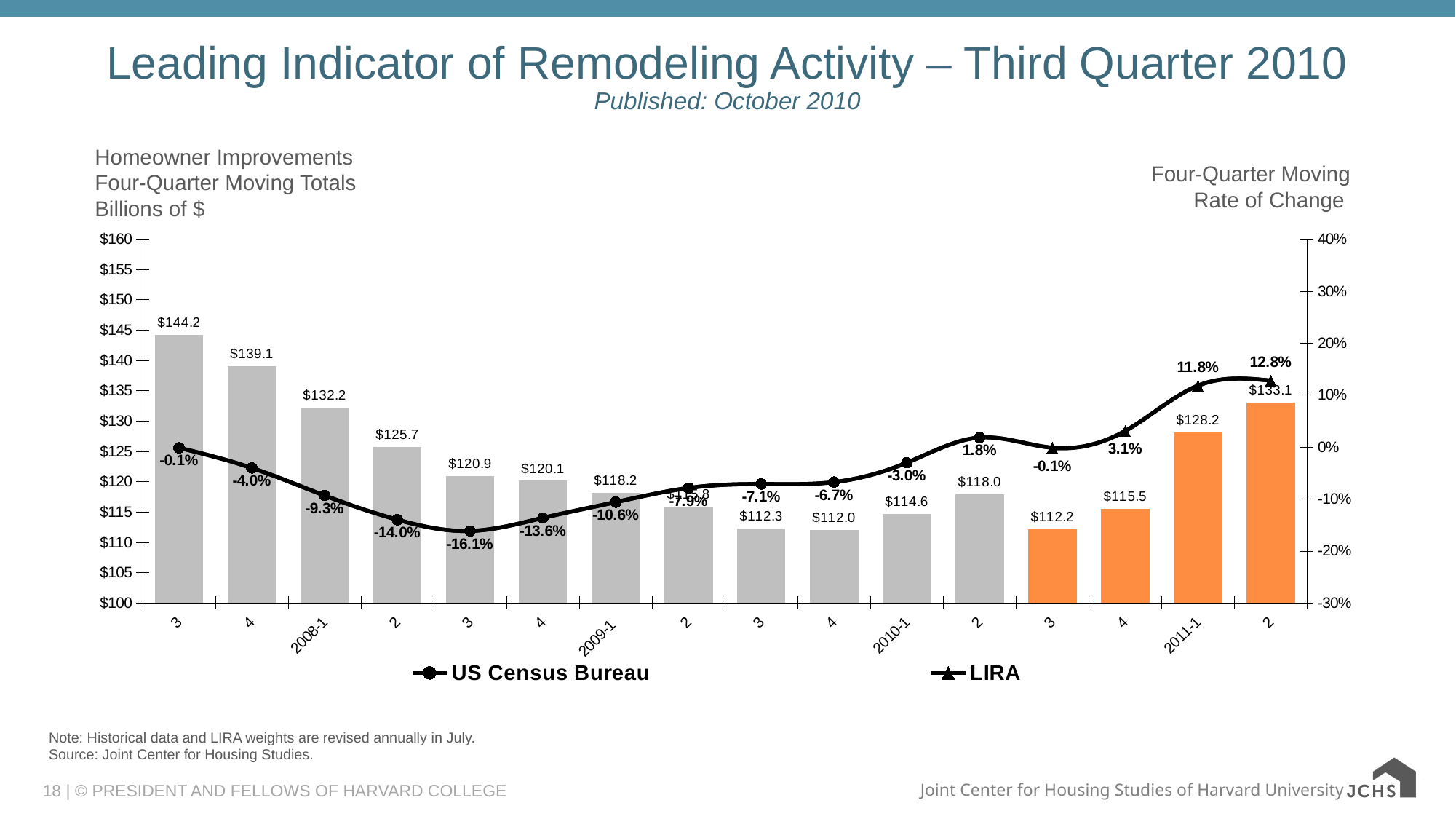
What is the highest Four-Quarter Moving Rate of Change value shown on the chart? 12.8% What is the value of the Homeowner Improvements bar for 2011-1? $128.2 Which quarter has the lowest Four-Quarter Moving Rate of Change? 2008 quarter 3 (the '3' after 2008-1), -16.1% Do the Homeowner Improvements bars rise or fall from 2008-1 to 2009-1? Fall What kind of chart is shown on the slide? A combination bar and line chart Which is larger, the Homeowner Improvements bar for 2010-1 or for 2009-1? 2009-1 What is the value of the Homeowner Improvements bar for 2008-1? $132.2 How many bars are plotted on the chart? 16 Which quarter has the highest Homeowner Improvements bar? The first bar (labeled quarter 3, before 2008-1), $144.2 What is the Four-Quarter Moving Rate of Change shown for 2010-1? -3.0% How many series does the legend list? 2 What is the difference between the Homeowner Improvements bars for 2011-1 and the following quarter (2011 quarter 2)? $4.9